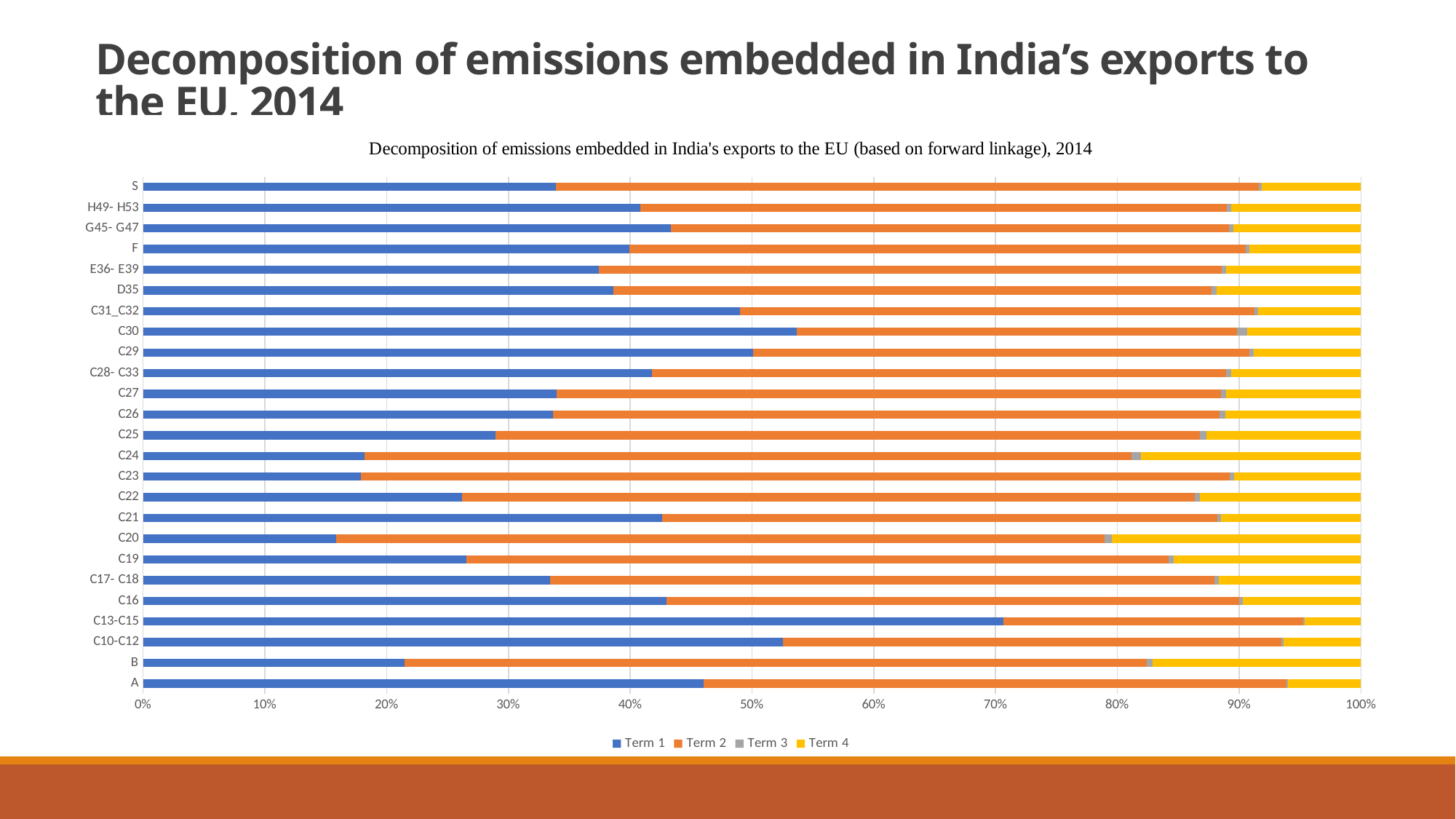
Which category has the largest Term 1 share? C13-C15 Is the Term 1 value for A greater or less than 40%? greater Is the Term 1 value for C13-C15 greater or less than 60%? greater What are the four legend entries of the chart? Term 1, Term 2, Term 3, Term 4 How many series does the legend list? 4 Which category has the smallest Term 1 share? C20 Is the Term 1 value for C20 greater or less than 20%? less Which has the larger Term 1 share, A or B? A What kind of chart is shown on the slide? bar chart What does each stacked bar total on the horizontal axis? 100% How many categories are plotted on the vertical axis? 25